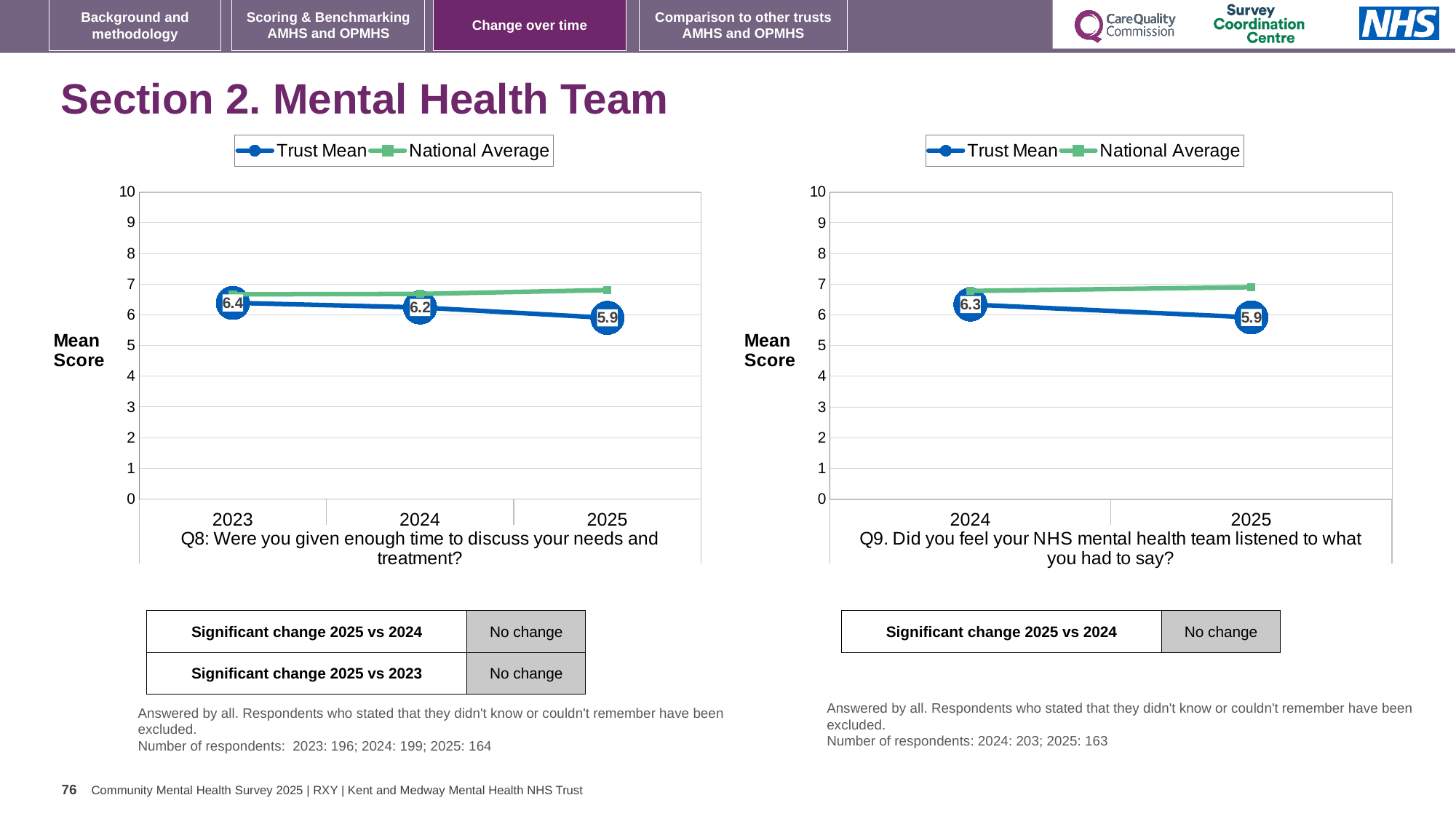
In the Q8 chart (left), does the Trust Mean rise or fall from 2023 to 2025? fall In the Q8 chart (left), what is the Trust Mean for 2023? 6.4 In the Q9 chart (right), is the National Average for 2025 greater or less than 6? greater In the Q8 chart (left), what is the Trust Mean for 2025? 5.9 In the Q8 chart (left), which year has the highest Trust Mean? 2023 In the Q8 chart (left), which is larger in 2025, the Trust Mean or the National Average? National Average How many years are plotted on the x axis of the Q9 chart (right)? 2 In the Q9 chart (right), what is the difference between the Trust Mean in 2024 and in 2025? 0.4 How many series does the legend of the Q8 chart (left) list? 2 In the Q8 chart (left), what is the difference between the Trust Mean in 2023 and in 2025? 0.5 In the Q9 chart (right), what is the Trust Mean for 2024? 6.3 In the Q9 chart (right), which year has the lowest Trust Mean? 2025